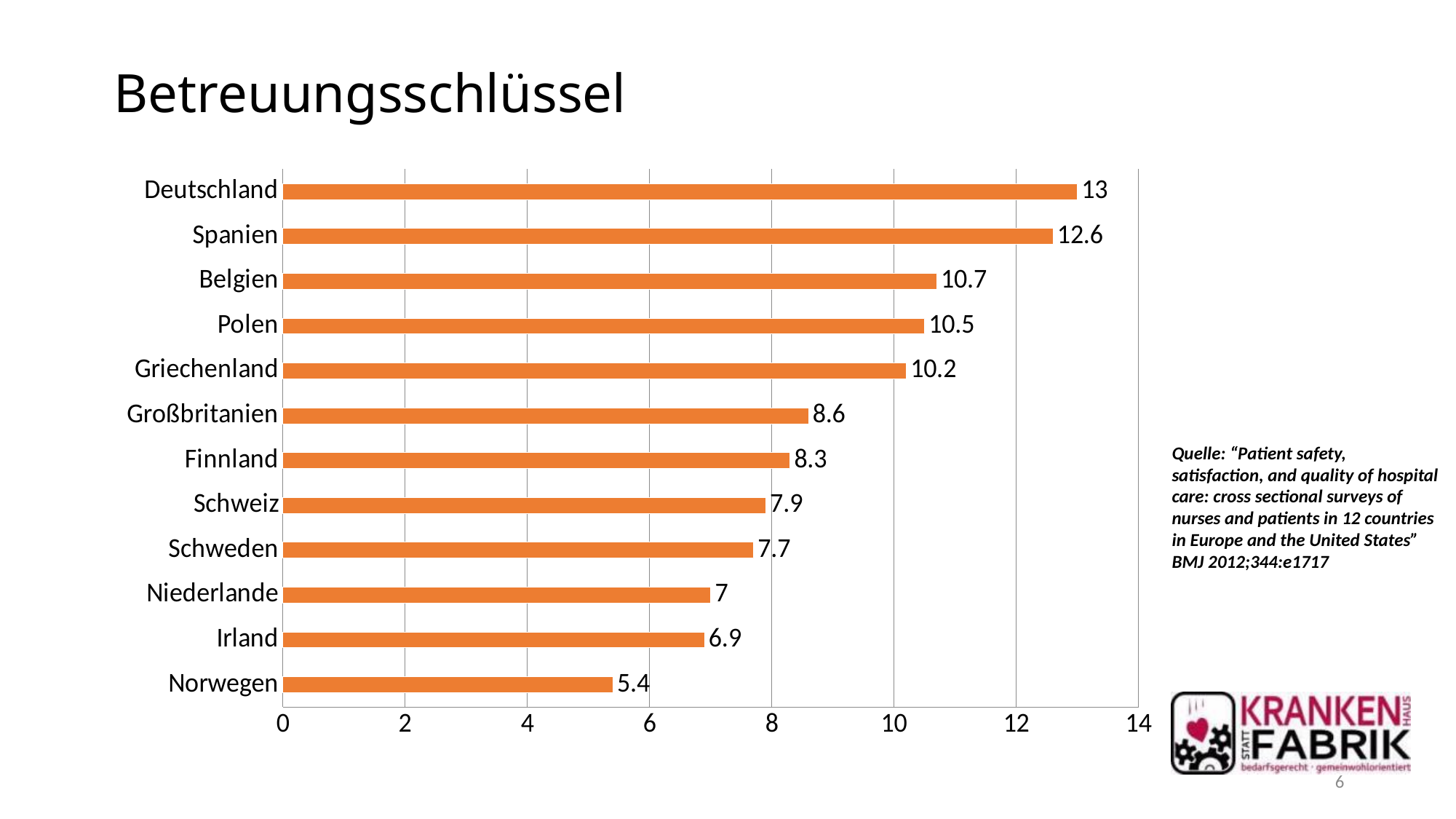
How many countries are shown in the chart? 12 What is the value for Norwegen? 5.4 What is the difference between the values for Deutschland and Norwegen? 7.6 Which country has the lowest value? Norwegen Which has a larger value, Finnland or Großbritanien? Großbritanien Is the value for Polen greater or less than 10? greater What is the value for Deutschland? 13 What kind of chart is shown on the slide? bar chart What is the difference between the values for Spanien and Belgien? 1.9 Which country has the highest value? Deutschland What is the title of the slide? Betreuungsschlüssel What is the value for Schweiz? 7.9